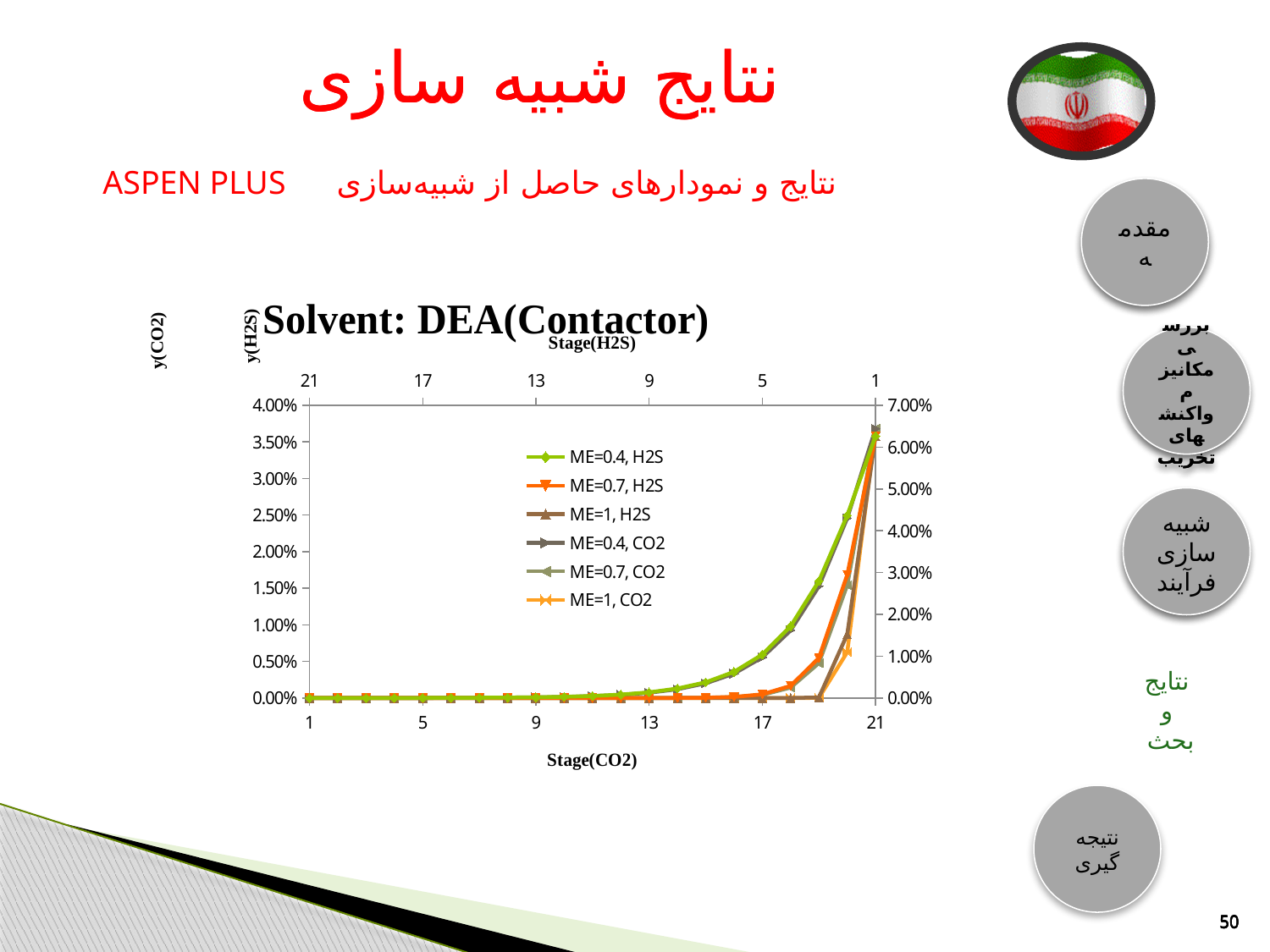
What is the last stage number shown on the bottom x axis of the chart? 21 Is the value for ME=1, CO2 at stage 1 on the bottom axis greater or less than 1.00%? less What is the title of the chart? Solvent: DEA(Contactor) What kind of chart is shown on the slide? line chart What is the highest tick value shown on the right y axis of the chart? 7.00% What is the highest tick value shown on the left y axis of the chart? 4.00% Along the bottom x axis (Stage(CO2)), do the plotted values rise or fall as the stage number increases from 1 to 21? rise Is the value for ME=0.4, H2S at stage 9 on the bottom axis greater or less than 1.00%? less How many series does the legend of the chart list? 6 What is the label of the bottom x axis of the chart? Stage(CO2)